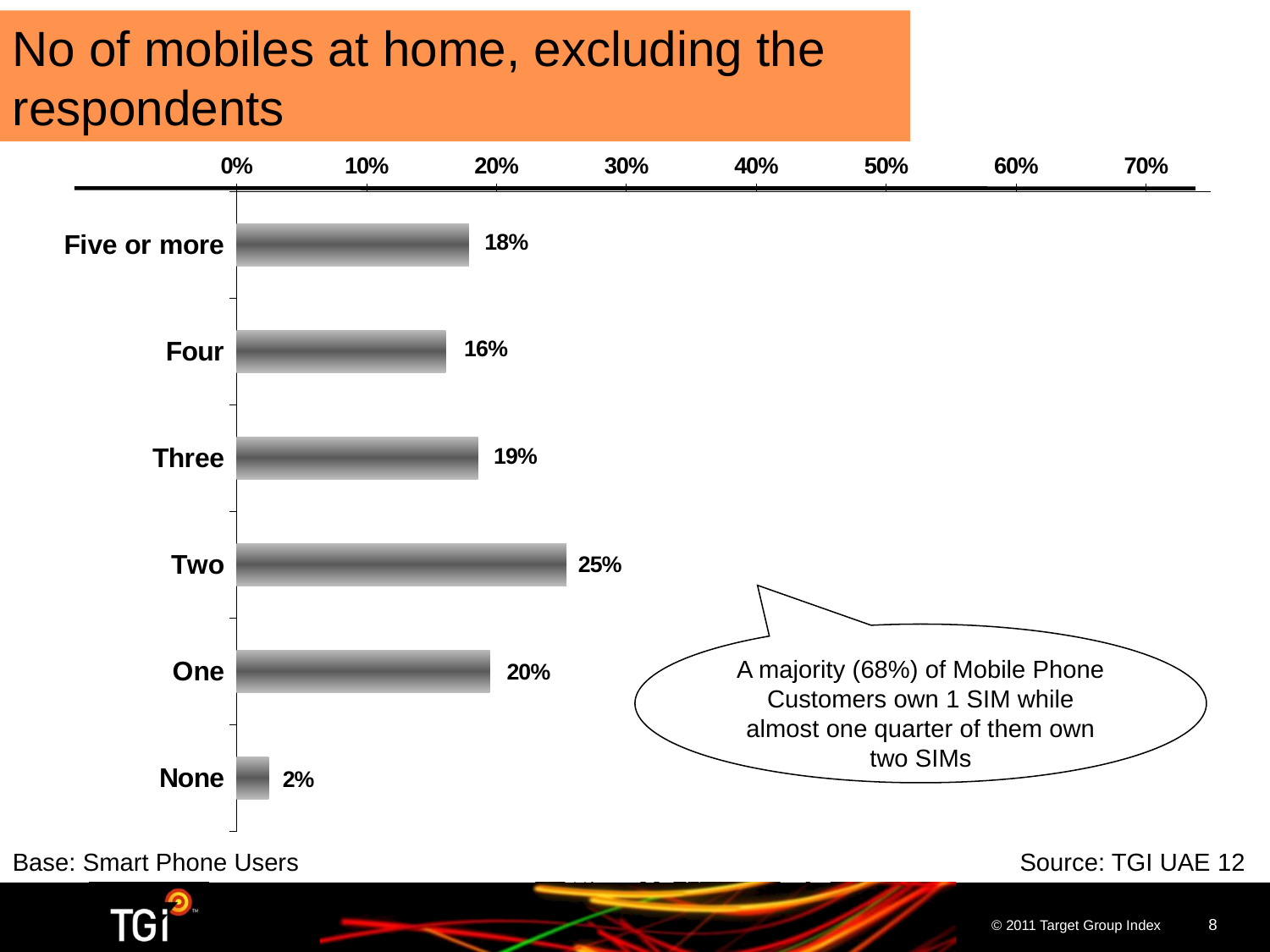
What is the difference between the values for Three and Four? 3% Which is larger, the value for Four or the value for Five or more? Five or more What is the title of the chart on the slide? No of mobiles at home, excluding the respondents What is the difference between the values for Two and One? 5% How many categories are shown in the chart? 6 Which category has the highest value? Two What is the value for None? 2% What is the value for Five or more? 18% What kind of chart is shown on the slide? bar chart Which category has the lowest value? None What is the value for Two? 25% Is the value for Two greater or less than 30%? less